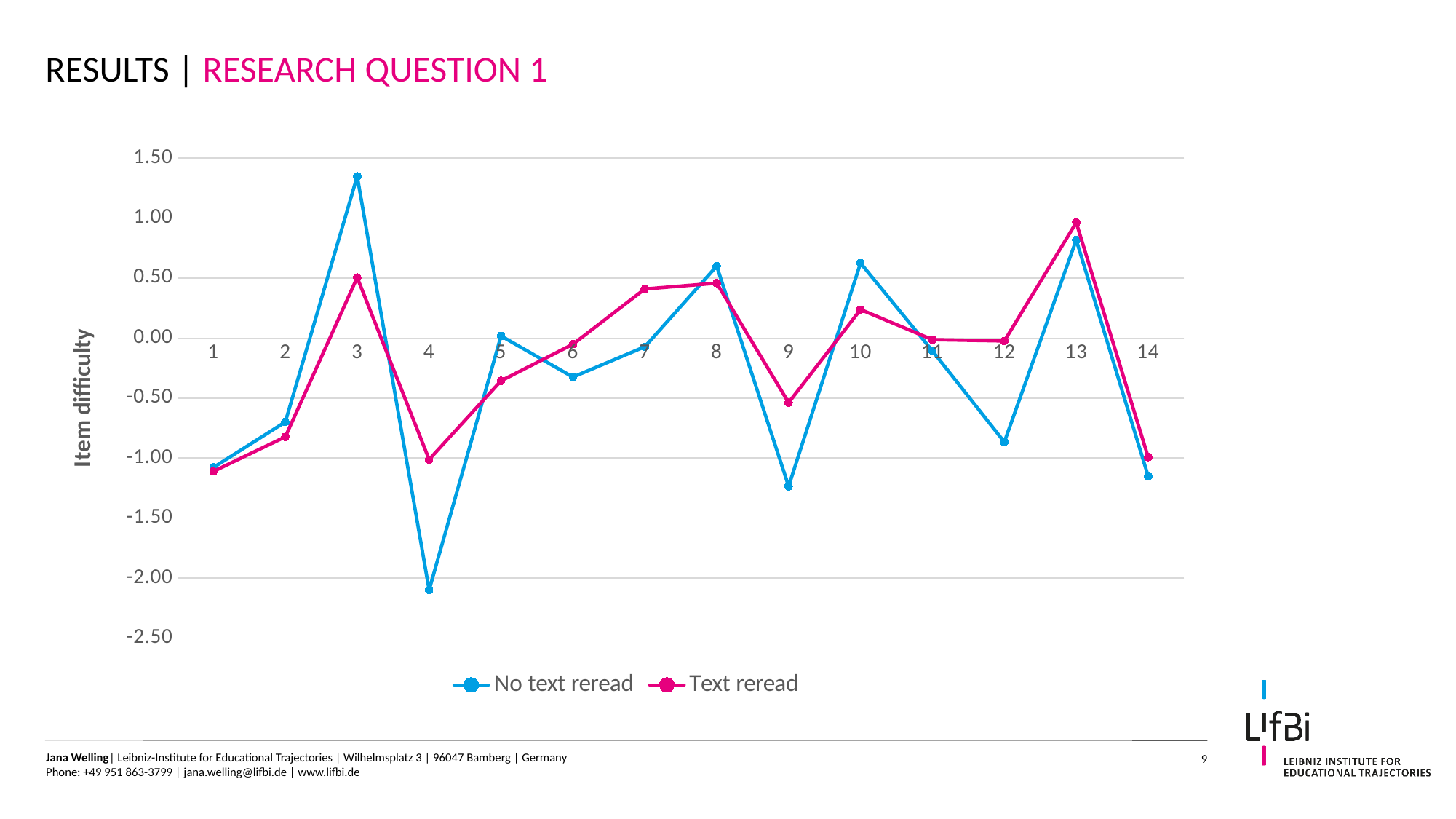
At item 4, which series has the lower value, 'No text reread' or 'Text reread'? No text reread For the 'No text reread' series, which item has the lowest item difficulty? 4 At item 7, which series has the higher value, 'No text reread' or 'Text reread'? Text reread How many series does the legend list? 2 How many items are plotted along the x axis? 14 At item 3, which series has the higher value, 'No text reread' or 'Text reread'? No text reread What kind of chart is shown on the slide? line chart Is the 'No text reread' value for item 3 greater or less than 1.00? greater For the 'Text reread' series, which item has the highest item difficulty? 13 What is the label of the vertical axis? Item difficulty Is the 'No text reread' value for item 4 greater or less than -2.00? less For the 'No text reread' series, which item has the highest item difficulty? 3